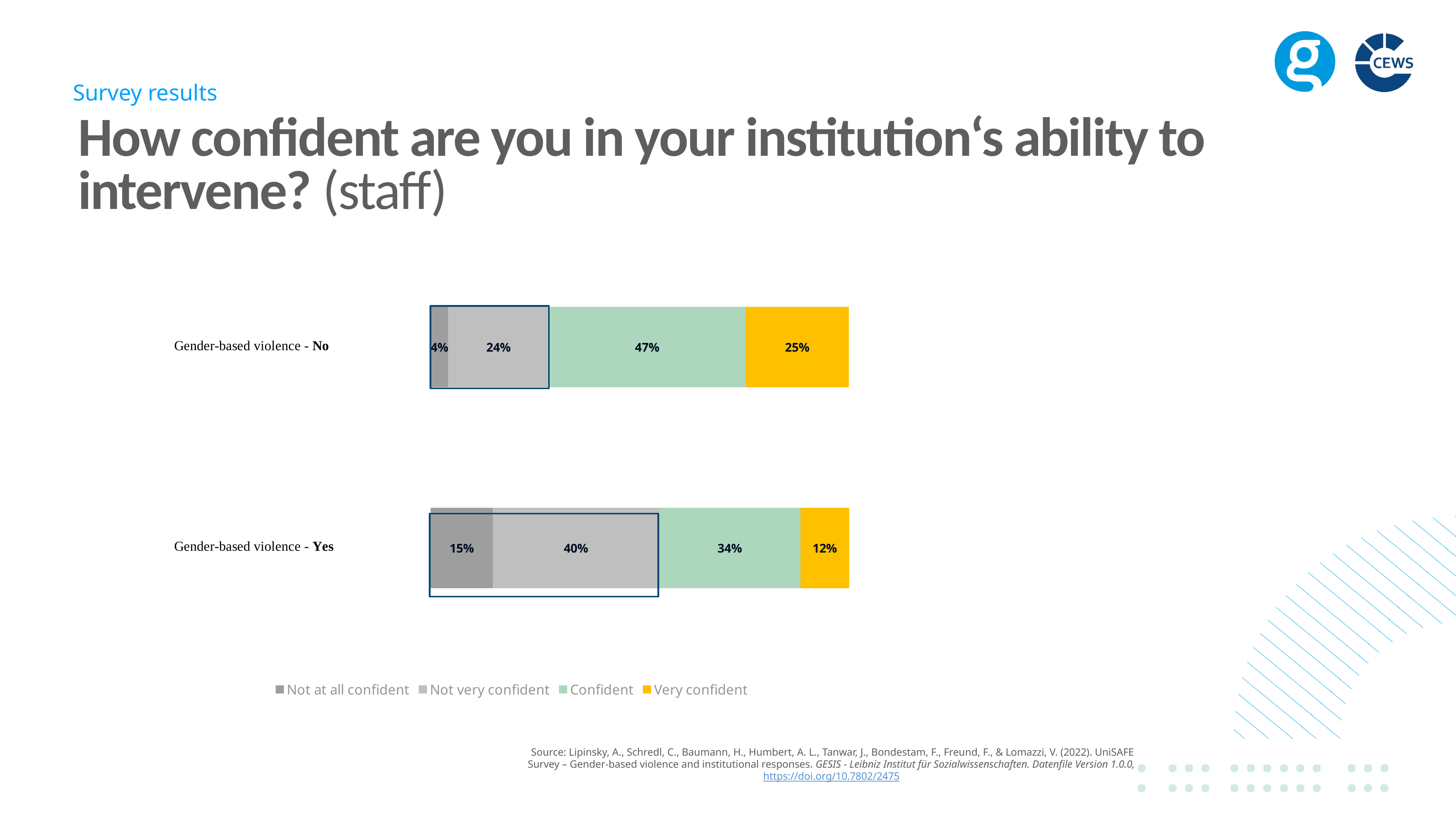
What percentage of staff who answered 'Gender-based violence - No' are 'Not at all confident'? 4% What is the difference between the 'Confident' shares for 'Gender-based violence - No' and 'Gender-based violence - Yes'? 13% How many series does the legend list? 4 What percentage of staff who answered 'Gender-based violence - Yes' are 'Not very confident'? 40% What percentage of staff who answered 'Gender-based violence - No' are 'Confident'? 47% Which response category has the largest share in the 'Gender-based violence - Yes' bar? Not very confident What kind of chart is shown on the slide? Stacked bar chart Which group has a larger 'Not at all confident' share: 'Gender-based violence - No' or 'Gender-based violence - Yes'? Gender-based violence - Yes What colour represents 'Very confident' in the chart? Yellow How many bars (categories) does the chart show? 2 Which response category has the smallest share in the 'Gender-based violence - No' bar? Not at all confident What percentage of staff who answered 'Gender-based violence - Yes' are 'Very confident'? 12%